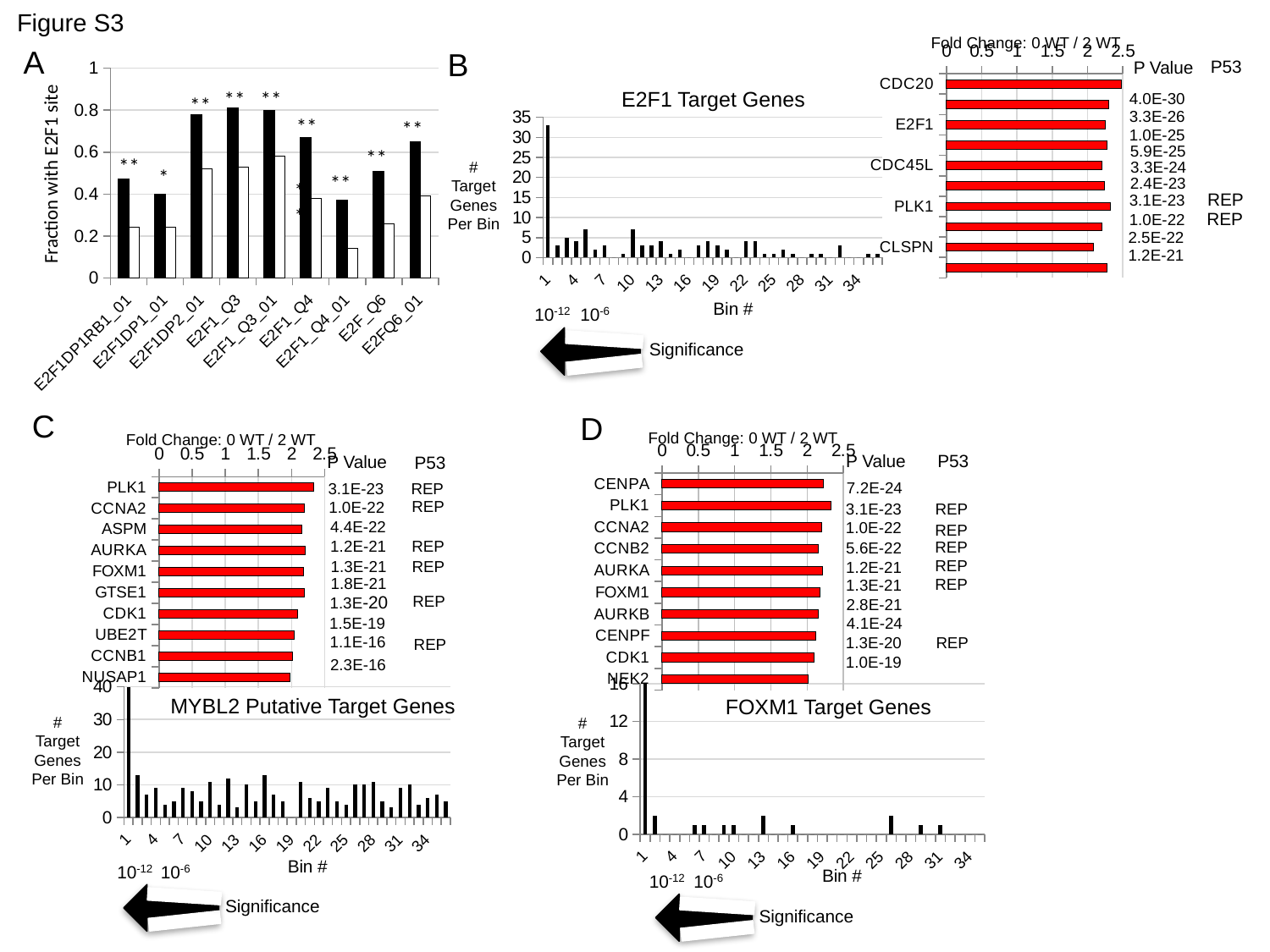
What is the title of the histogram in panel C? MYBL2 Putative Target Genes What kind of chart is shown in panel A? bar chart In panel A, is the white bar for E2F1_Q4_01 greater or less than 0.2? less How many categories are shown on the x axis of the panel A chart? 9 In the panel C fold change chart, what P value is listed for PLK1? 3.1E-23 How many genes are listed in the panel D fold change chart? 10 In the panel D fold change chart, what P value is listed for CENPA? 7.2E-24 In the MYBL2 Putative Target Genes histogram (panel C), which bin has the highest number of target genes? Bin 1 What is the title of the histogram in panel B? E2F1 Target Genes In the E2F1 Target Genes histogram (panel B), which bin has the highest number of target genes? Bin 1 In the E2F1 Target Genes histogram (panel B), is the value for bin 1 greater or less than 30? greater In panel A, is the black bar for E2F1DP1RB1_01 greater or less than 0.4? greater